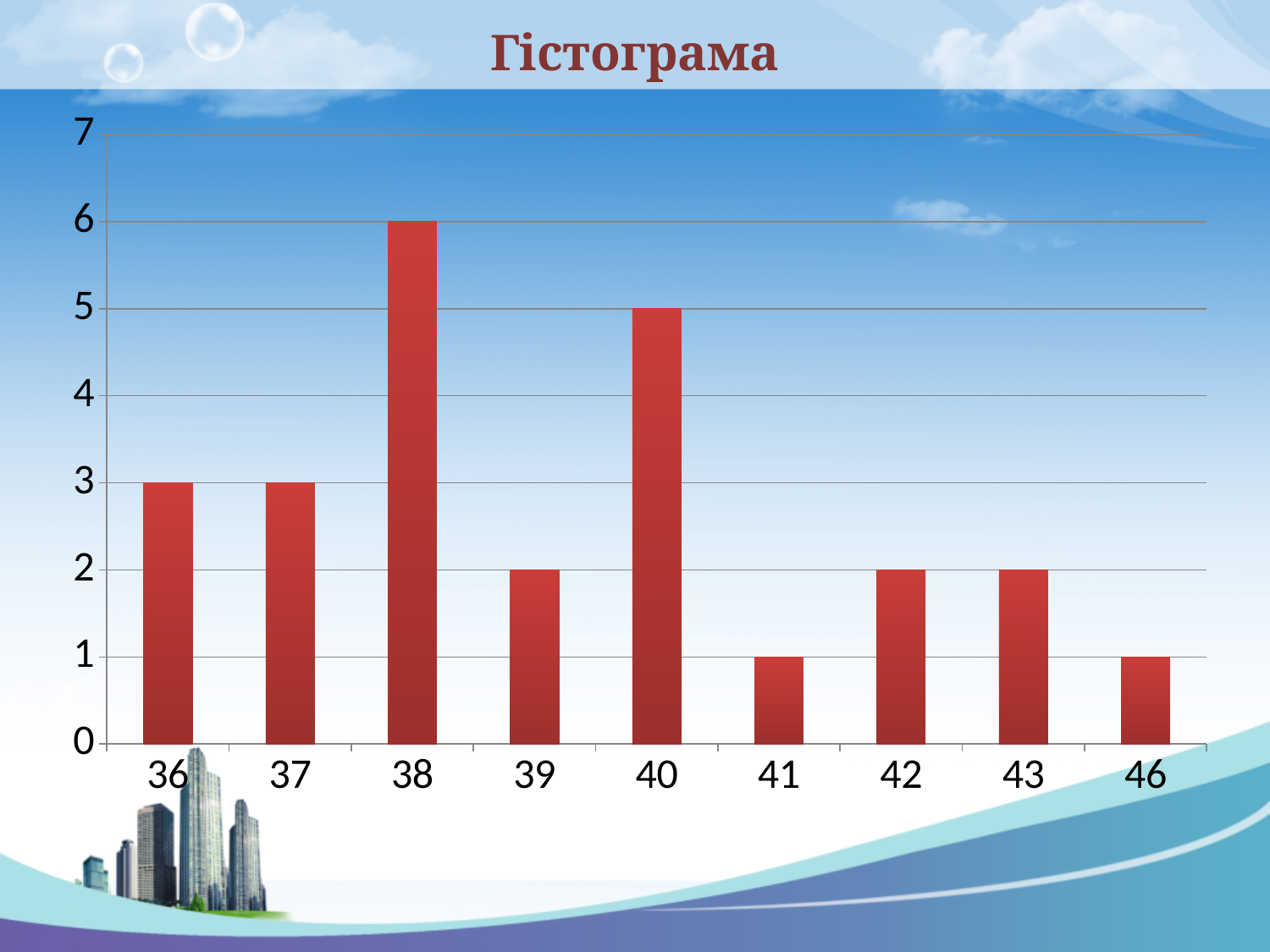
How many categories are shown on the x axis? 9 Which category has the highest value? 38 What is the value for category 40? 5 Is the value for 40 greater or less than 4? greater What kind of chart is shown on the slide? bar chart What is the value for category 41? 1 What is the title of the slide? Гістограма What is the difference between the values for 36 and 39? 1 What is the value for category 38? 6 What is the value for category 36? 3 Which is larger, the value for 37 or the value for 42? 37 What is the difference between the values for 38 and 40? 1